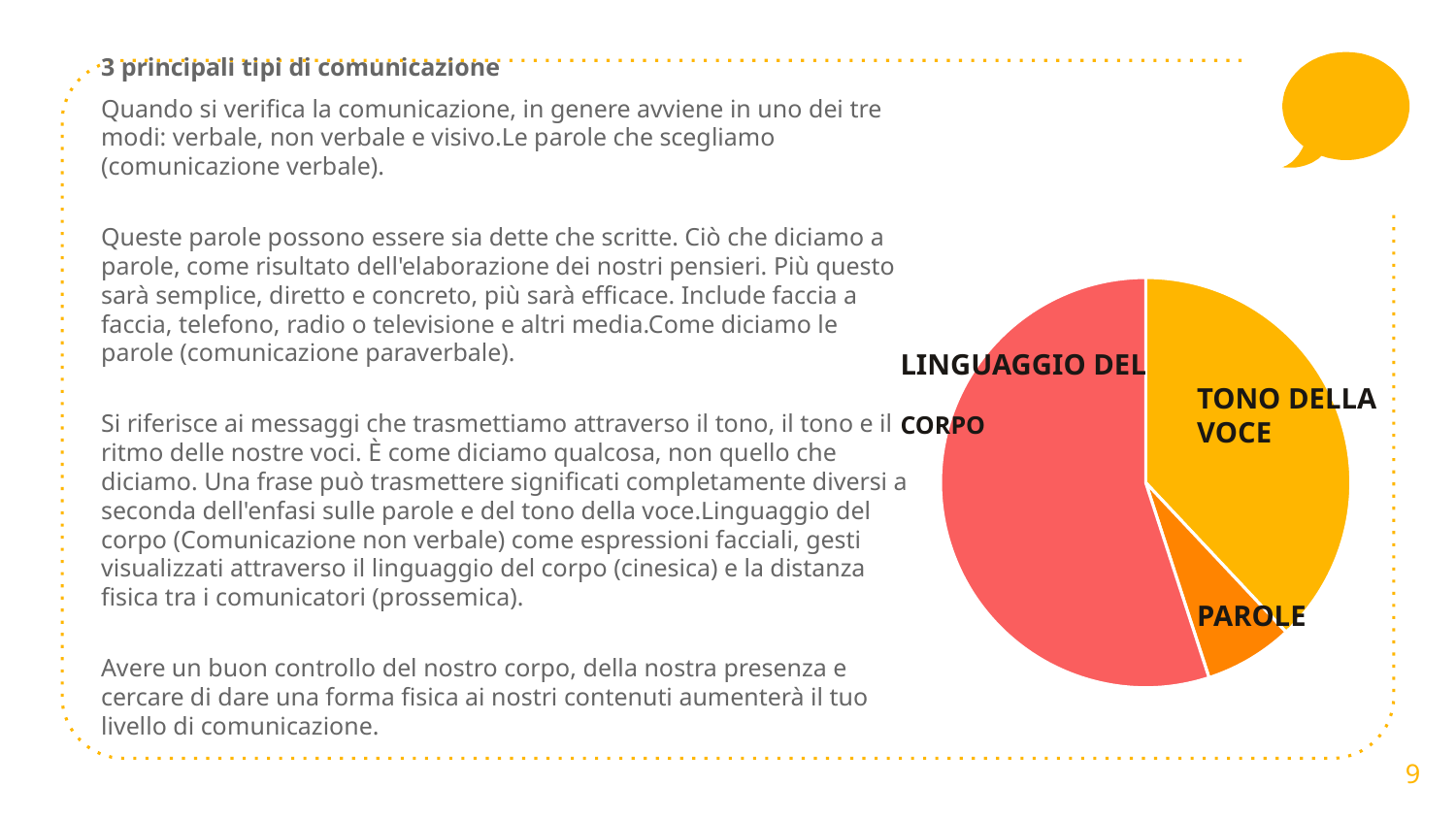
Which slice is smaller, PAROLE or LINGUAGGIO DEL CORPO? PAROLE Which slice is larger, PAROLE or TONO DELLA VOCE? TONO DELLA VOCE Which slice of the pie chart is the largest? LINGUAGGIO DEL CORPO How many slices does the pie chart have? 3 Which slice of the pie chart is coloured yellow? TONO DELLA VOCE Which slice is larger, LINGUAGGIO DEL CORPO or TONO DELLA VOCE? LINGUAGGIO DEL CORPO What colour is the LINGUAGGIO DEL CORPO slice of the pie chart? Red Which slice of the pie chart is the smallest? PAROLE What kind of chart is shown on the slide? Pie chart